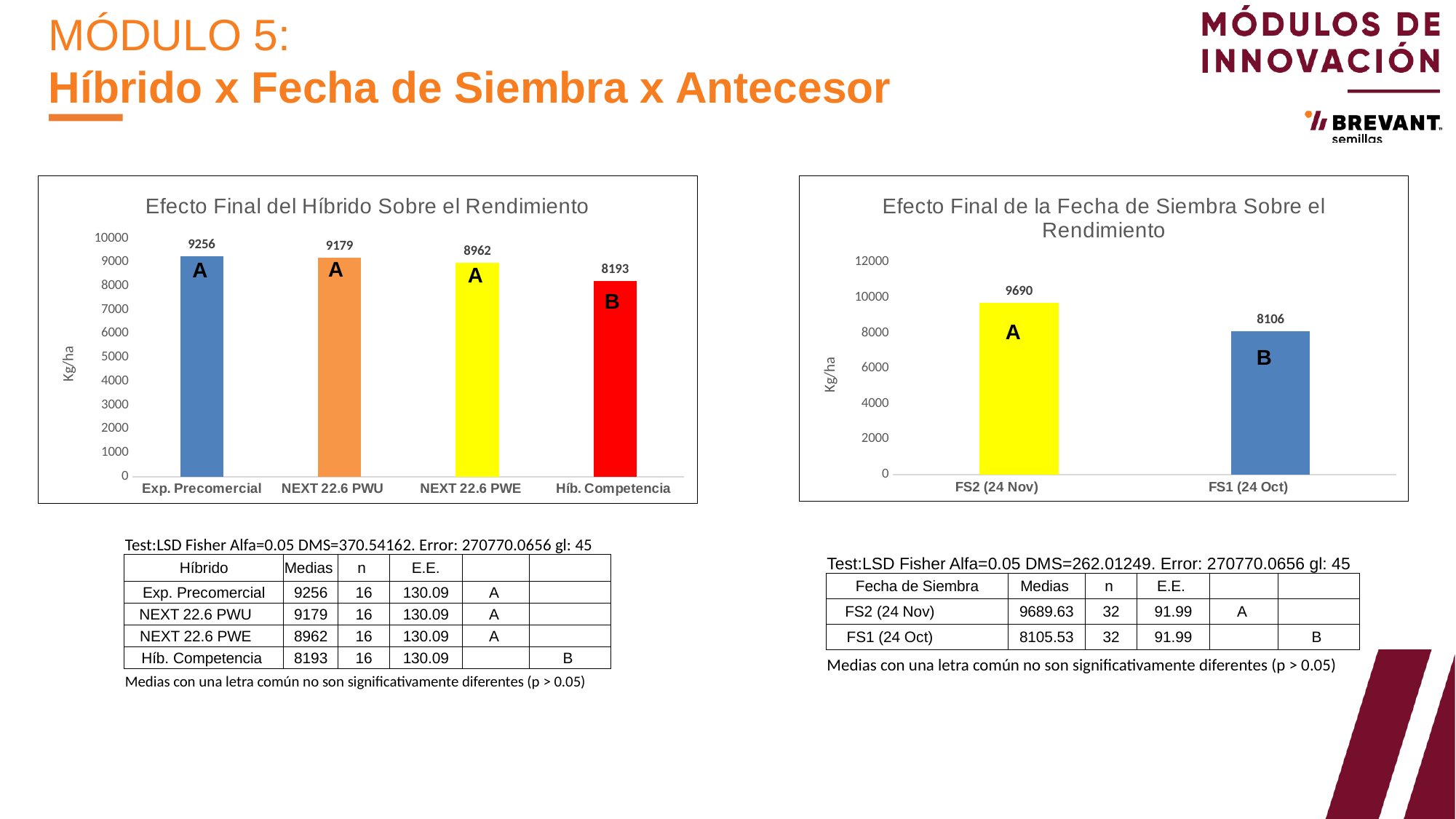
In the chart 'Efecto Final del Híbrido Sobre el Rendimiento', what is the value for NEXT 22.6 PWU? 9179 In the chart 'Efecto Final del Híbrido Sobre el Rendimiento', which category has the highest value? Exp. Precomercial In the chart 'Efecto Final de la Fecha de Siembra Sobre el Rendimiento', which category has the higher value, FS2 (24 Nov) or FS1 (24 Oct)? FS2 (24 Nov) In the chart 'Efecto Final de la Fecha de Siembra Sobre el Rendimiento', what is the value for FS1 (24 Oct)? 8106 In the chart 'Efecto Final del Híbrido Sobre el Rendimiento', what is the difference between Exp. Precomercial and Híb. Competencia? 1063 In the chart 'Efecto Final de la Fecha de Siembra Sobre el Rendimiento', what is the difference between FS2 (24 Nov) and FS1 (24 Oct)? 1584 In the chart 'Efecto Final del Híbrido Sobre el Rendimiento', what is the y-axis label? Kg/ha What kind of chart is 'Efecto Final de la Fecha de Siembra Sobre el Rendimiento'? bar chart In the chart 'Efecto Final del Híbrido Sobre el Rendimiento', which category has the lowest value? Híb. Competencia In the chart 'Efecto Final de la Fecha de Siembra Sobre el Rendimiento', what colour is the bar for FS2 (24 Nov)? yellow In the chart 'Efecto Final del Híbrido Sobre el Rendimiento', how many categories are plotted? 4 In the chart 'Efecto Final del Híbrido Sobre el Rendimiento', is the value for NEXT 22.6 PWE greater or less than 9000? less